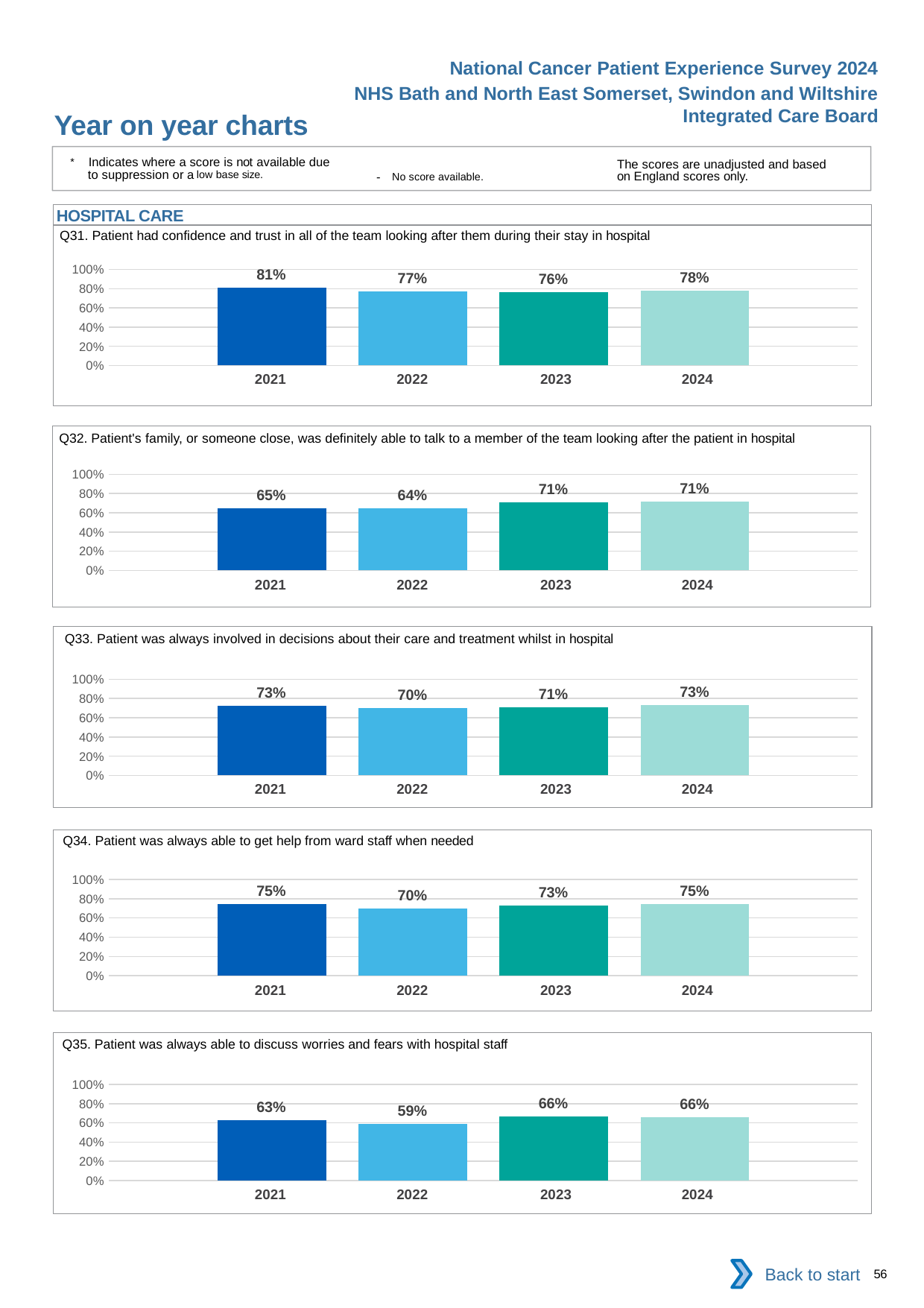
In the Q34 chart, which year has the lowest value? 2022 In the Q33 chart, which is larger, the value for 2021 or the value for 2022? 2021 In the Q32 chart, what is the difference between the 2023 and 2022 values? 7% In the Q35 chart, is the value for 2022 greater or less than 60%? less In the Q33 chart, how many years are plotted? 4 In the Q31 chart, what is the value for 2021? 81% In the Q34 chart, what is the difference between the 2021 and 2022 values? 5% In the Q35 chart, what is the value for 2022? 59% In the Q32 chart, do the values rise or fall from 2022 to 2023? rise In the Q32 chart, what is the value for 2024? 71% What kind of chart is the Q35 chart? bar chart In the Q31 chart, which year has the lowest value? 2023